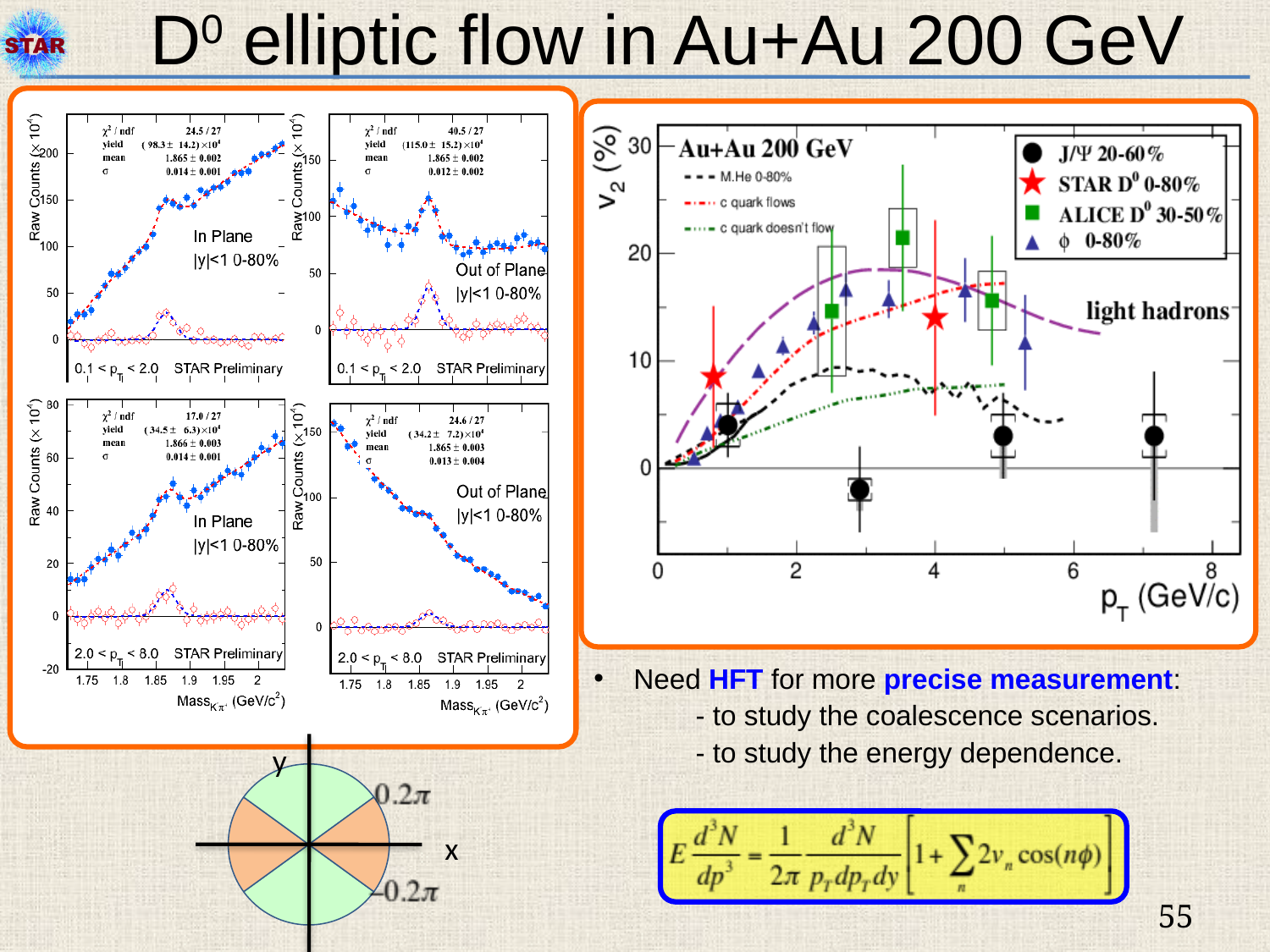
In the v2 versus pT chart on the right, what collision system is named in the chart's title label? Au+Au 200 GeV In the v2 versus pT chart on the right, how many data series does the legend box in the upper right list? 4 Comparing the fitted yields printed in the fit boxes, which is larger: the top-left In Plane plot (0.1 < pT < 2.0) or the top-right Out of Plane plot (0.1 < pT < 2.0)? Top-right Out of Plane plot In the v2 versus pT chart on the right, is the v2 value of the J/Ψ point near pT = 3 GeV/c greater or less than 0? less In the v2 versus pT chart on the right, how many red star (STAR D0) data points are plotted? 2 In the v2 versus pT chart on the right, is the v2 value of the ALICE D0 point near pT = 3.5 GeV/c greater or less than 20? greater In the bottom-left invariant mass plot (In Plane, 2.0 < pT < 8.0), what is the fitted yield printed in the fit box? (34.5 ± 6.3)×10^4 In the v2 versus pT chart on the right, how many green square (ALICE D0 30-50%) data points are plotted? 3 In the v2 versus pT chart on the right, which marker symbol represents STAR D0 0-80%? Red star In the top-left invariant mass plot (In Plane, 0.1 < pT < 2.0), what is the fitted mean value printed in the fit box? 1.865 ± 0.002 In the v2 versus pT chart on the right, is the v2 value of the STAR D0 point near pT = 4 GeV/c greater or less than 10? greater In the top-right invariant mass plot (Out of Plane, 0.1 < pT < 2.0), what is the χ²/ndf printed in the fit box? 40.5 / 27